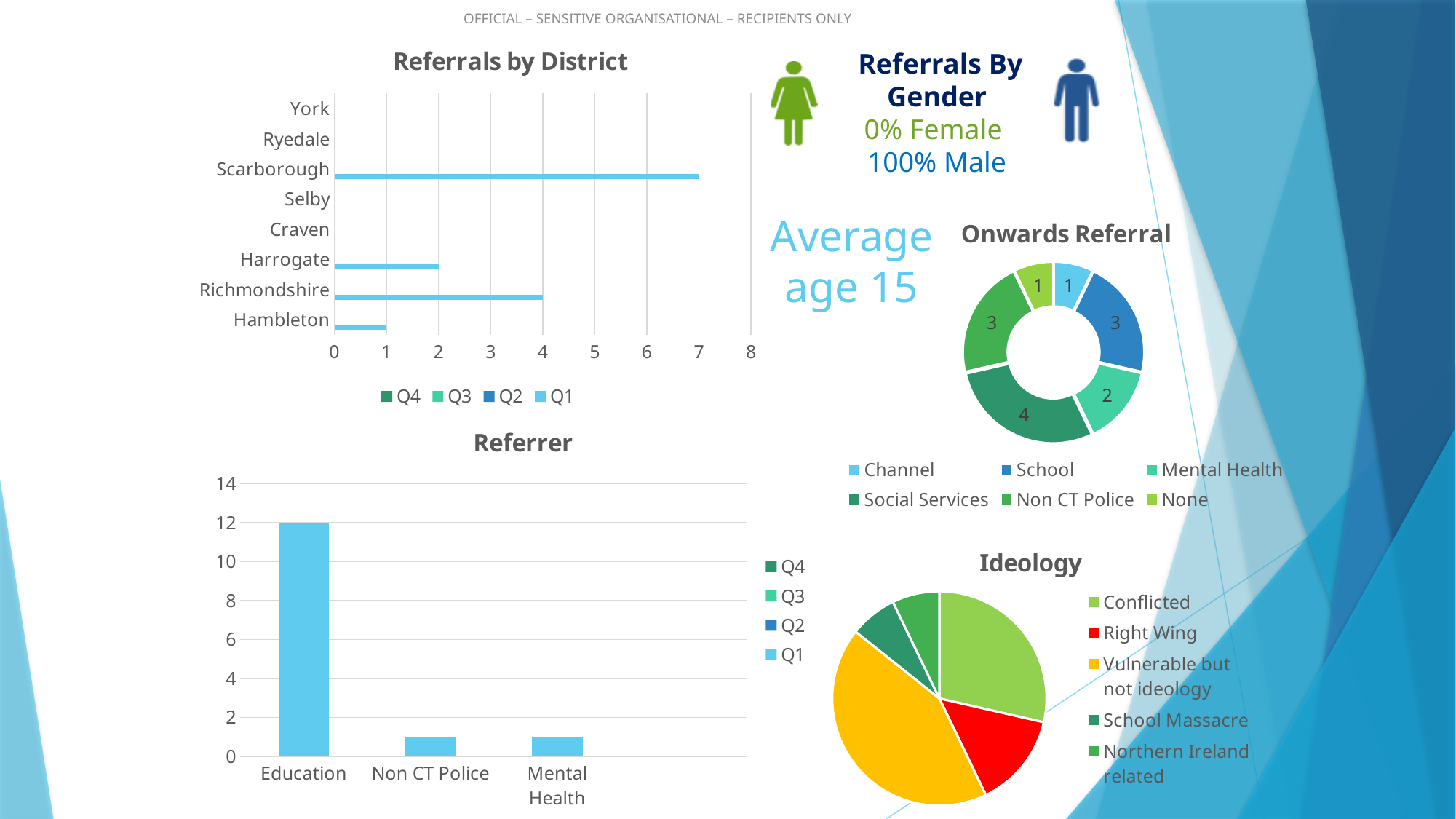
In the Referrals by District chart, how many series does the legend list? 4 In the Ideology chart, which category has the largest slice? Vulnerable but not ideology In the Referrals by District chart, which district has the highest value? Scarborough In the Referrer chart, what is the value for Education? 12 In the Referrals by District chart, how many districts are listed on the axis? 8 In the Onwards Referral chart, what is the total of all the segment values? 14 In the Referrer chart, which category has the highest value? Education In the Onwards Referral chart, what is the value for Social Services? 4 In the Referrals by District chart, what is the value for Scarborough? 7 In the Referrals by District chart, what is the difference between the values for Scarborough and Richmondshire? 3